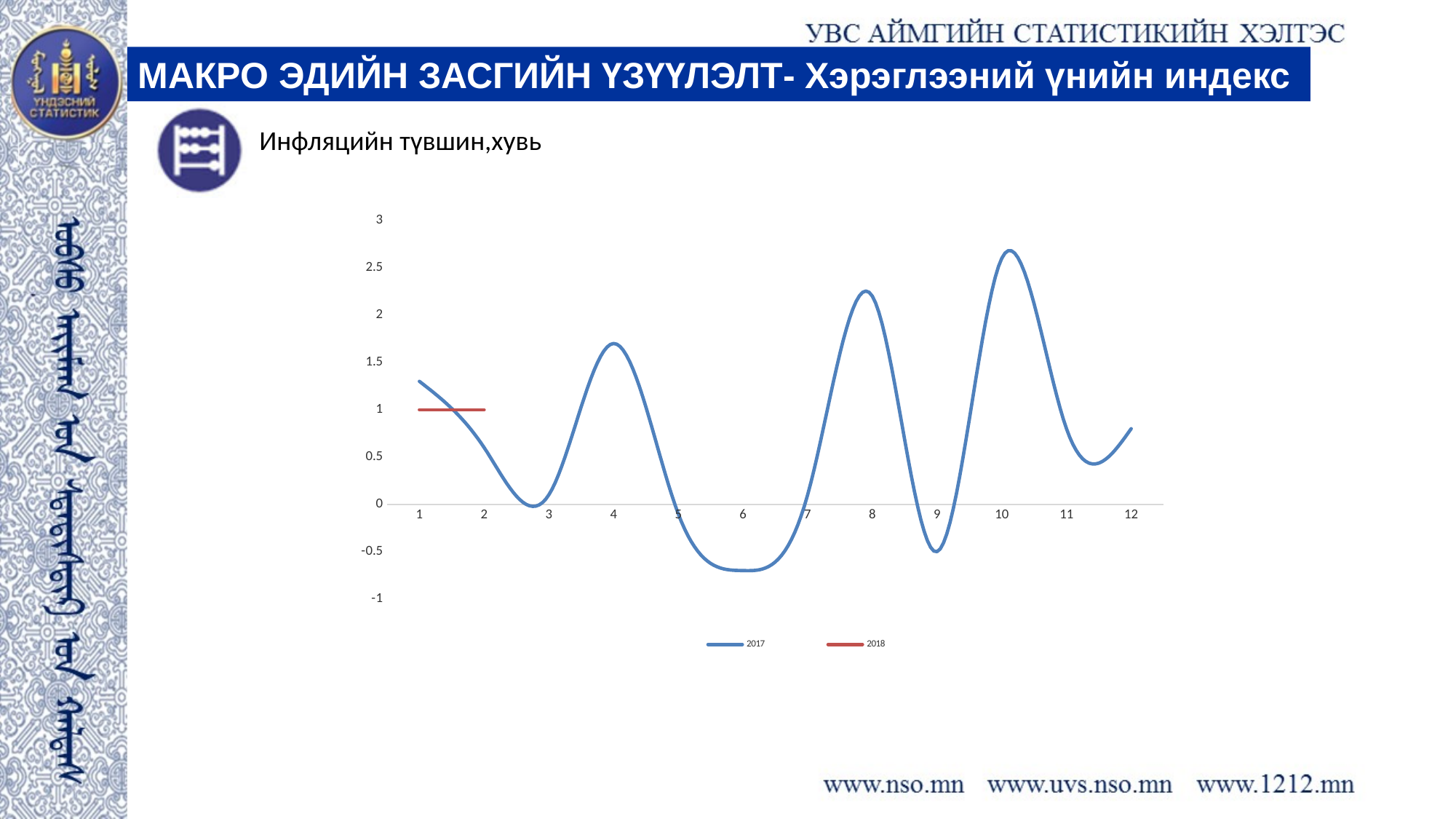
Which is larger for the 2017 series: the value at point 10 or the value at point 8? point 10 At which x-axis point does the 2017 series reach its highest value? 10 Does the 2017 series rise or fall from point 1 to point 3? fall How many points are labelled along the x axis? 12 Is the 2017 value at point 9 greater or less than 0? less What kind of chart is shown on the slide? line chart At which x-axis point does the 2017 series reach its lowest value? 6 Is the 2017 value at point 8 greater or less than 2? greater Which is larger for the 2017 series: the value at point 1 or the value at point 2? point 1 How many series does the legend list? 2 Is the 2017 value at point 6 greater or less than 0? less What are the two series named in the legend? 2017 and 2018